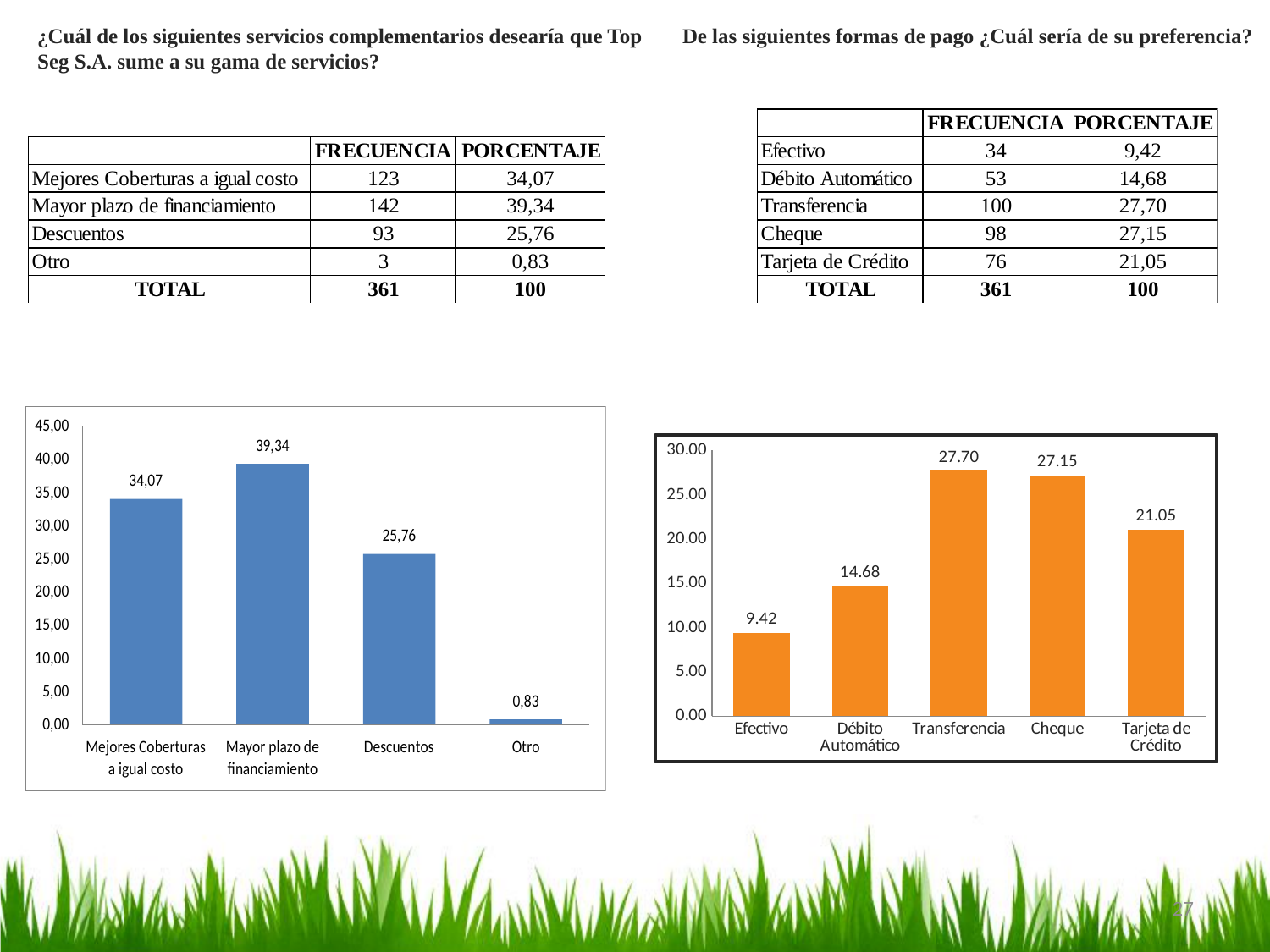
In the right chart, which is larger, the value for Cheque or the value for Tarjeta de Crédito? Cheque In the right chart, which category has the highest value? Transferencia How many categories are shown in the right chart? 5 In the left chart, what is the value for Descuentos? 25,76 What type of chart is the right chart? bar chart In the right chart, what is the value for Débito Automático? 14.68 In the right chart, which category has the lowest value? Efectivo In the left chart, is the value for Otro greater or less than 5,00? less How many categories are shown in the left chart? 4 In the left chart, which category has the highest value? Mayor plazo de financiamiento In the left chart, what is the difference between the values for Mayor plazo de financiamiento and Mejores Coberturas a igual costo? 5,27 In the right chart, what is the difference between the values for Transferencia and Efectivo? 18.28